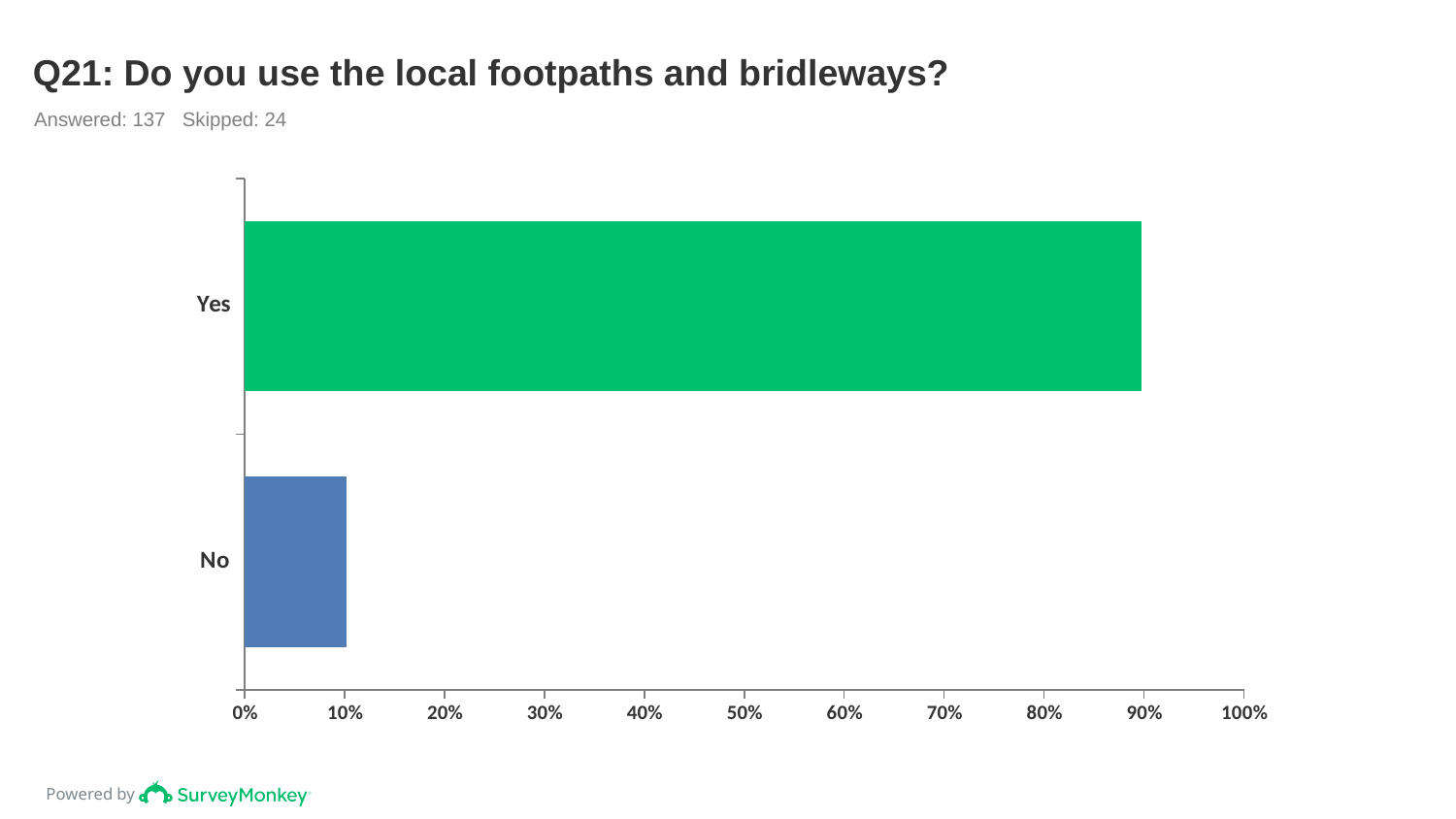
Which category has the lowest value? No What kind of chart is shown on the slide? bar chart Is the value for Yes greater or less than 80%? greater Is the value for Yes greater or less than 50%? greater Which category has the highest value? Yes Which is larger, the value for Yes or the value for No? Yes How many categories are plotted in the chart? 2 Is the value for No greater or less than 20%? less How many respondents answered the question according to the slide? 137 What is the title of the chart? Q21: Do you use the local footpaths and bridleways?